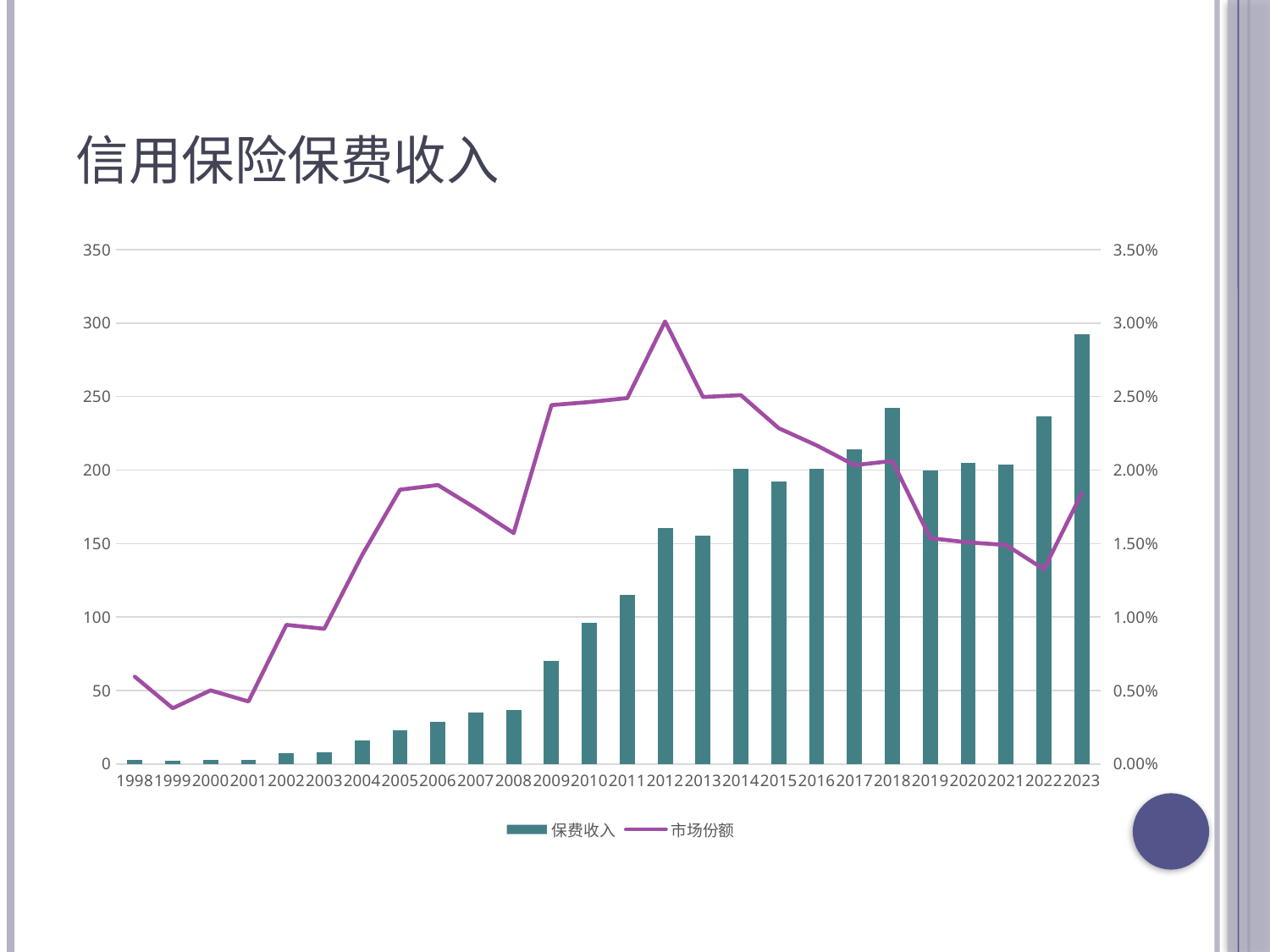
What kind of chart is this? Combination bar and line chart How many series does the legend list? 2 Is the 保费收入 value for 2023 greater or less than 250? greater Which year has the larger 保费收入 bar, 2018 or 2019? 2018 Which year has the highest 保费收入 bar? 2023 How many years are shown on the x axis? 26 Is the 保费收入 value for 2009 greater or less than 100? less Is the 市场份额 value for 2012 greater or less than 2.50%? greater What is the title of the chart? 信用保险保费收入 Overall, do the 保费收入 bars rise or fall from 1998 to 2023? rise In which year does the 市场份额 line reach its highest point? 2012